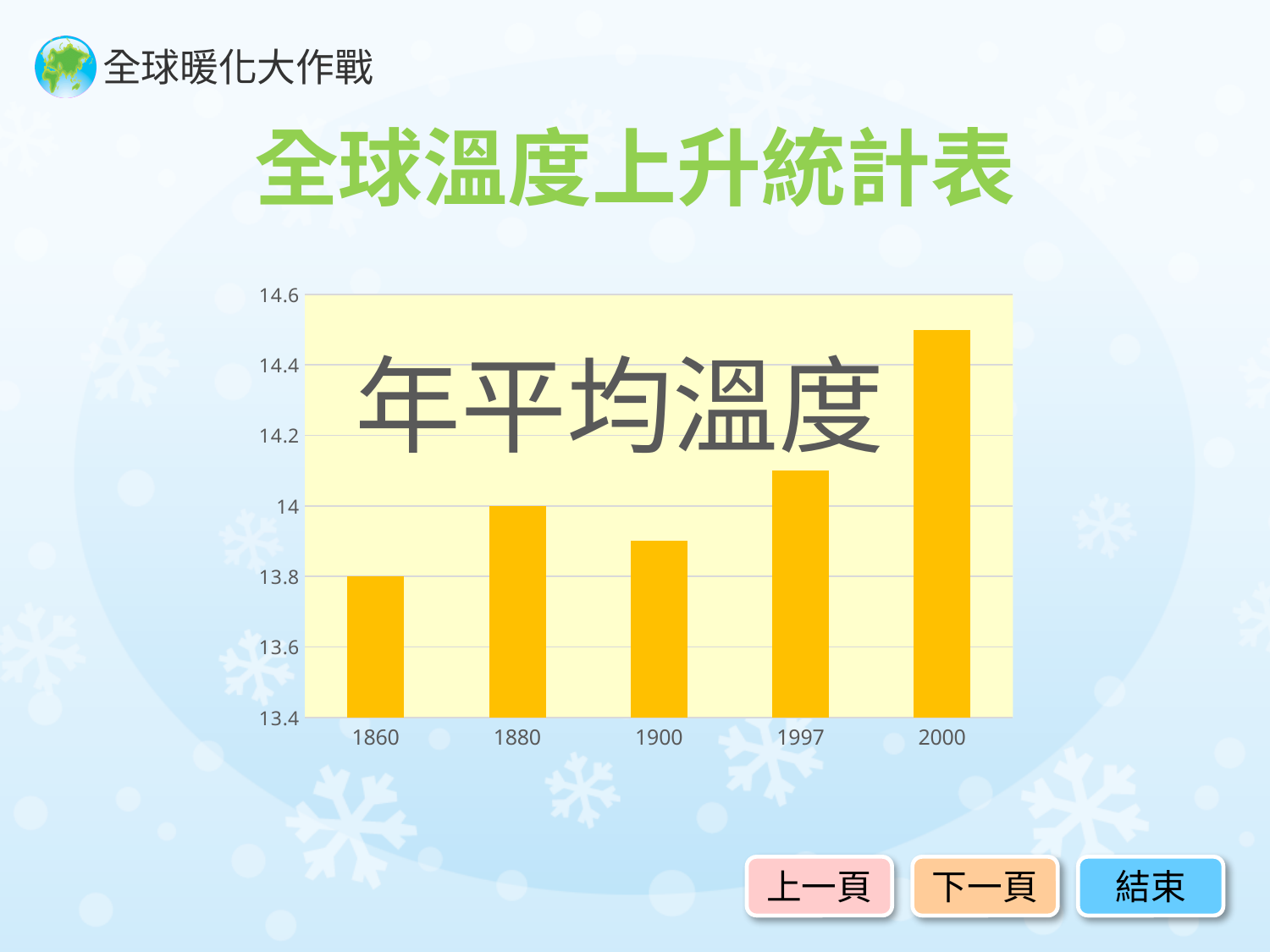
Is the value for 1900 greater or less than 14? less Which year has the lowest bar? 1860 Is the value for 1997 greater or less than 14? greater Which is larger, the value for 1880 or the value for 1900? 1880 Is the value for 2000 greater or less than 14.4? greater What is the difference between the values for 1880 and 1860? 0.2 What is the title of the slide above the chart? 全球溫度上升統計表 What is the value for 1860? 13.8 How many years are shown on the x axis? 5 What is the value for 1880? 14 What kind of chart is shown on the slide? bar chart Which year has the highest bar? 2000